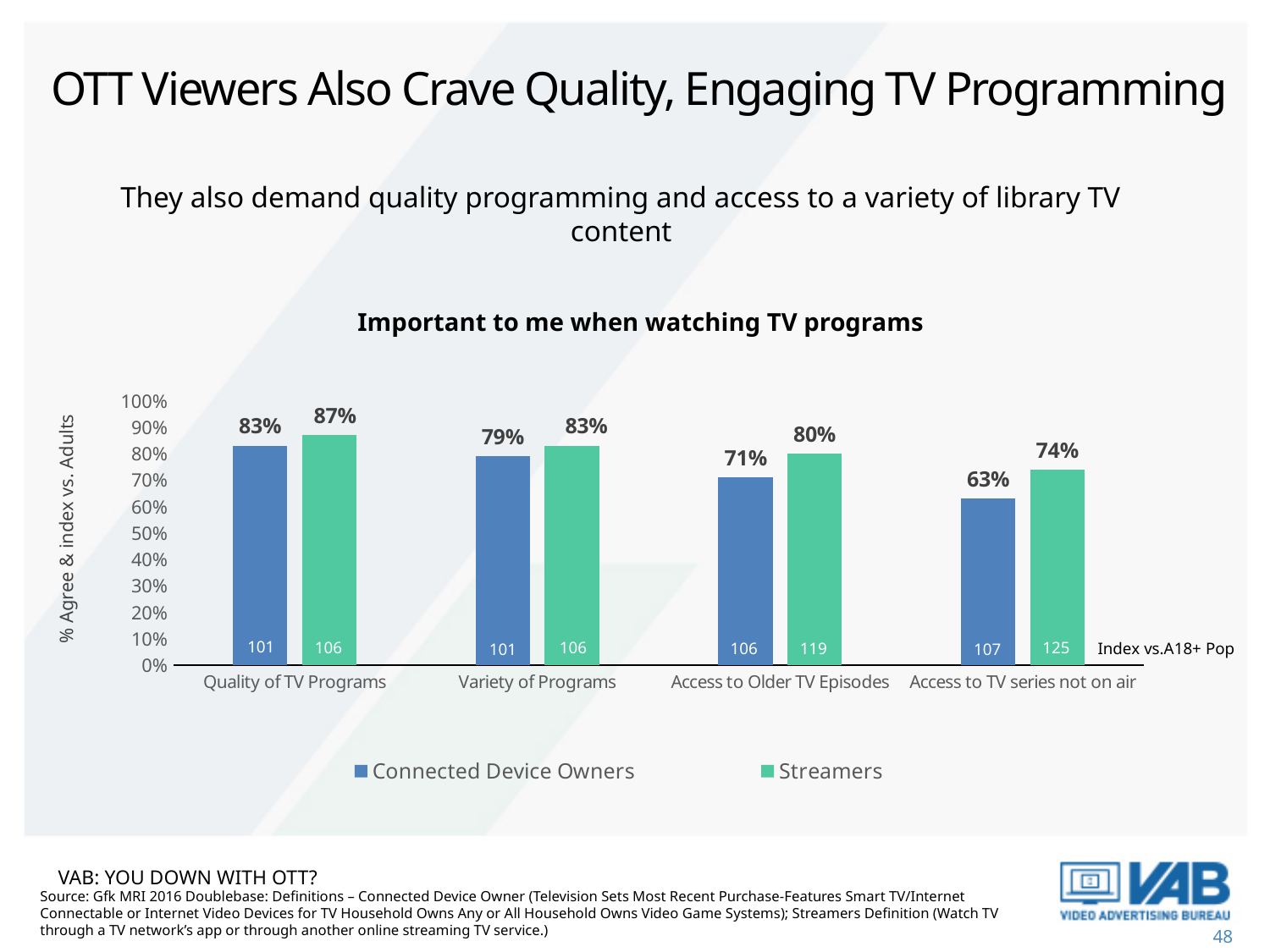
How many series does the legend list? 2 What percentage of Connected Device Owners say Access to TV series not on air is important? 63% How many categories are shown on the x axis of the chart? 4 Which category has the lowest value for Streamers? Access to TV series not on air What is the difference between Streamers and Connected Device Owners for Access to TV series not on air? 11% Which category has the highest value for Connected Device Owners? Quality of TV Programs What percentage of Streamers say Quality of TV Programs is important to them when watching TV programs? 87% Which is larger for Access to Older TV Episodes: Connected Device Owners or Streamers? Streamers Do the Connected Device Owners values rise or fall from left to right across the categories? Fall What is the index vs. A18+ Pop for Streamers on Access to TV series not on air? 125 What kind of chart is shown on the slide? Bar chart What is the title of the chart? Important to me when watching TV programs